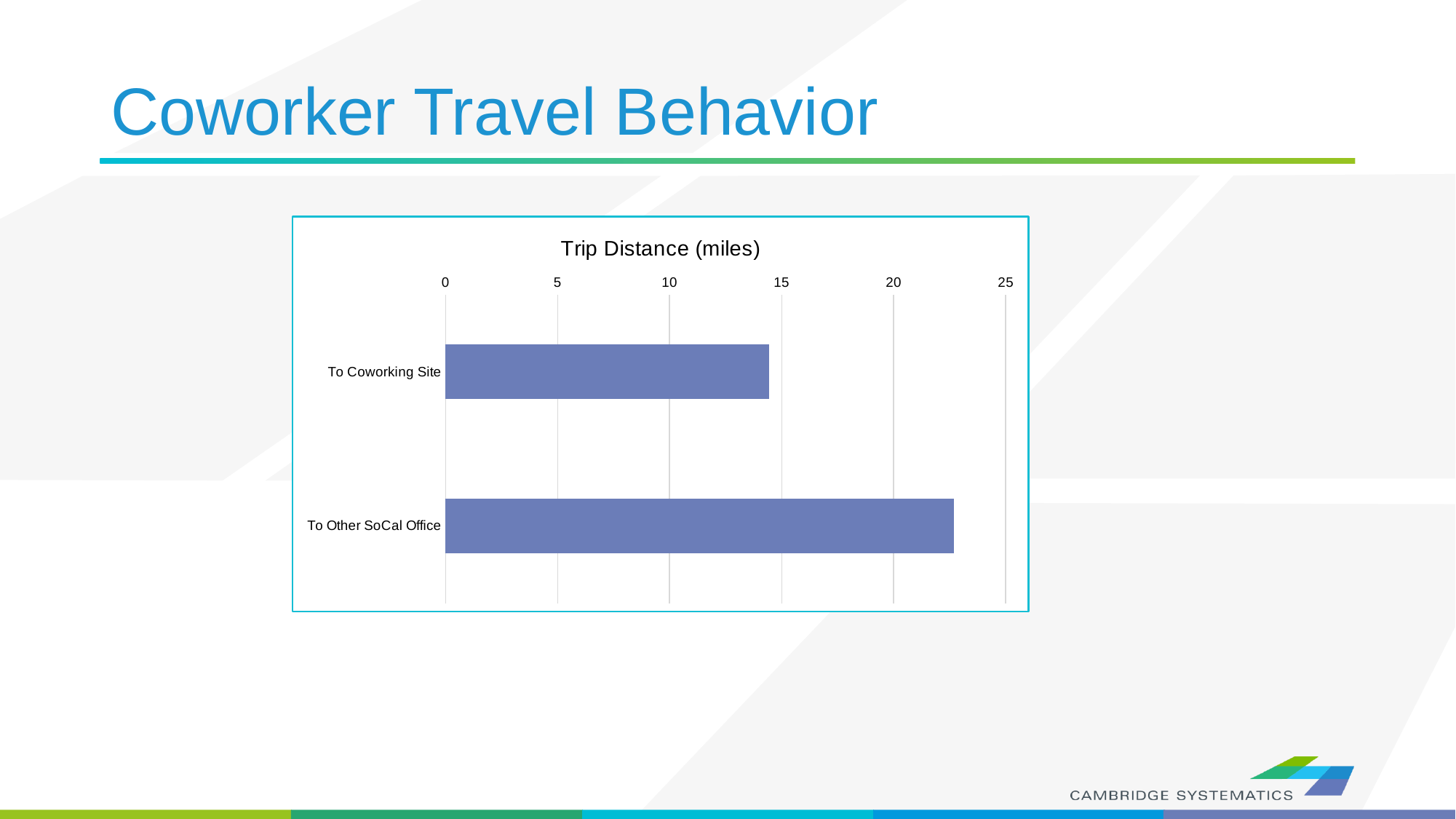
Which category has the shortest trip distance? To Coworking Site How many categories are plotted in the chart? 2 Which is larger, the trip distance To Coworking Site or To Other SoCal Office? To Other SoCal Office Is the trip distance for To Coworking Site greater or less than 10? greater Is the trip distance for To Other SoCal Office greater or less than 20? greater Is the trip distance for To Other SoCal Office greater or less than 25? less What kind of chart is shown on the slide? bar chart What is the highest value shown on the chart's horizontal axis? 25 What is the title of the chart? Trip Distance (miles) Which category has the longest trip distance? To Other SoCal Office